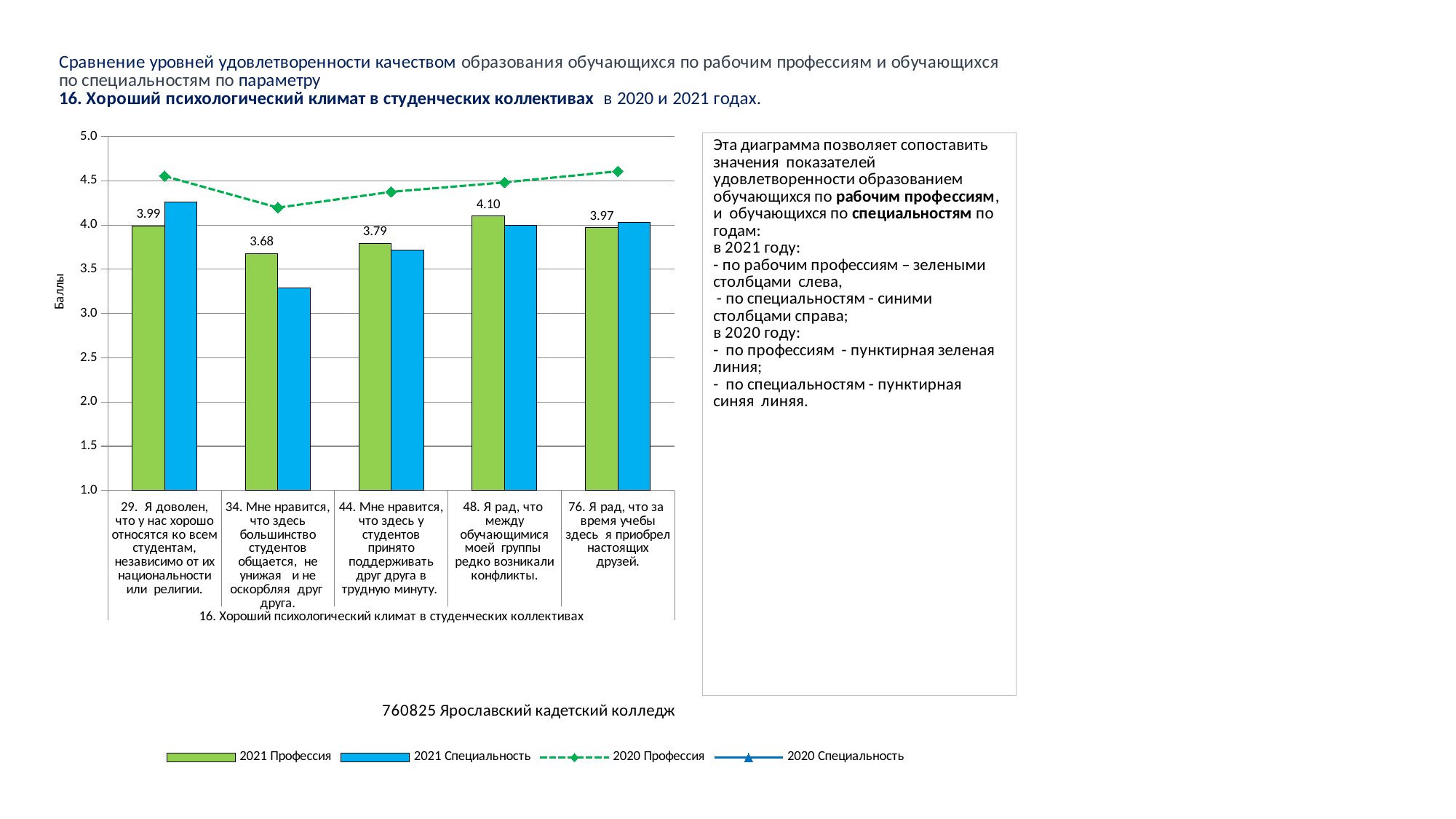
Which item has the lowest 2021 Профессия value? 34. Мне нравится, что здесь большинство студентов общается, не унижая и не оскорбляя друг друга. Is the 2020 Профессия value for item 34 greater or less than 4.0? greater For item 29, which is larger: the 2021 Профессия bar or the 2021 Специальность bar? 2021 Специальность What is the 2021 Профессия value for item 34 (Мне нравится, что здесь большинство студентов общается, не унижая и не оскорбляя друг друга)? 3.68 What is the 2021 Профессия value for item 48 (Я рад, что между обучающимися моей группы редко возникали конфликты)? 4.10 What is the difference between the highest and lowest 2021 Профессия values? 0.42 What is the label of the vertical axis? Баллы Which item has the highest 2021 Профессия value? 48. Я рад, что между обучающимися моей группы редко возникали конфликты. How many items (categories) are shown on the x axis? 5 Is the 2021 Специальность value for item 34 greater or less than 3.5? less What is the 2021 Профессия value for item 29 (Я доволен, что у нас хорошо относятся ко всем студентам...)? 3.99 How many series does the legend list? 4